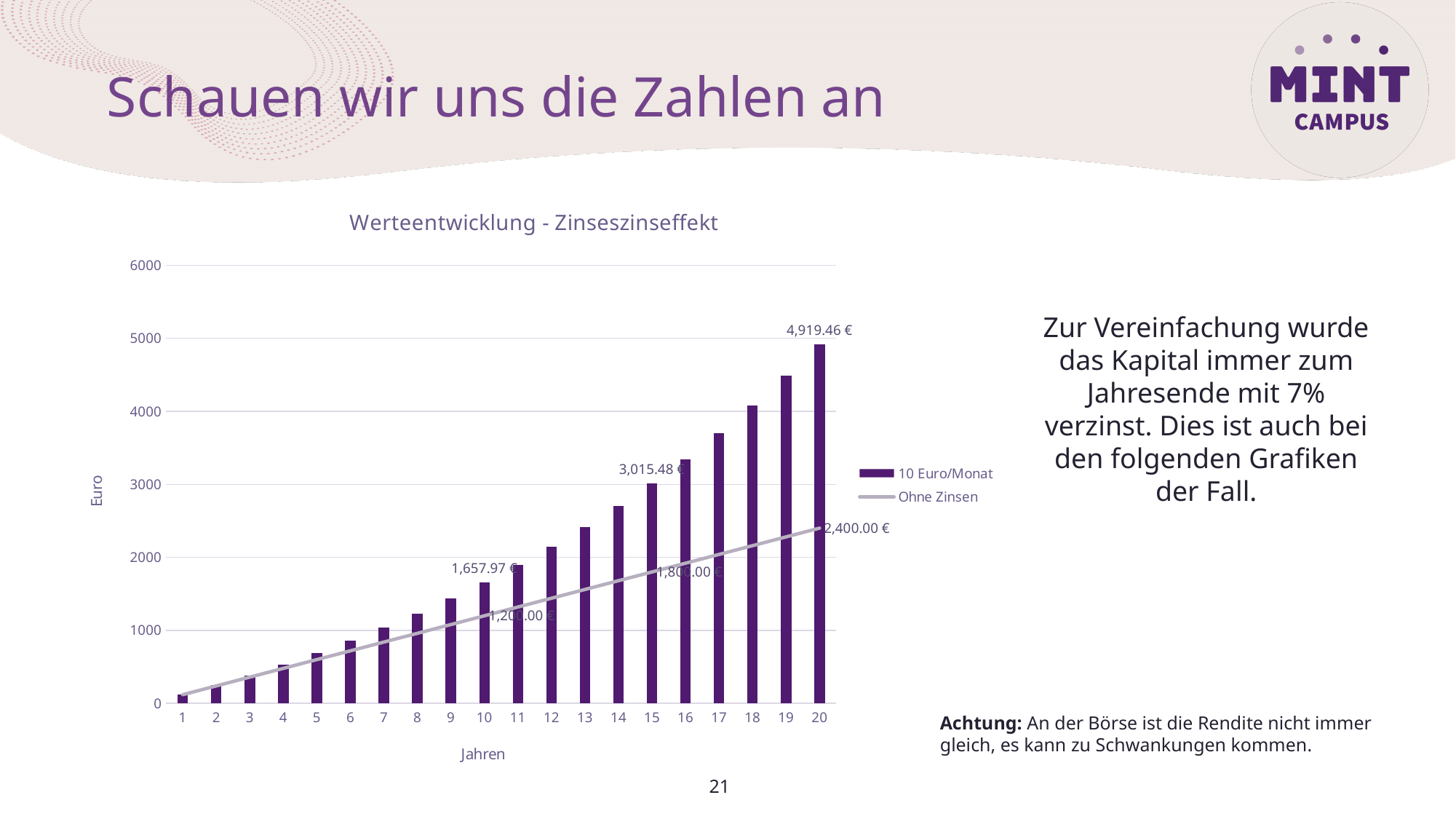
In which year is the 10 Euro/Monat bar the highest? 20 What is the difference between the 10 Euro/Monat value and the Ohne Zinsen value in year 20? 2,519.46 € How many series does the legend list? 2 Is the 10 Euro/Monat value in year 5 greater or less than 1000? less What is the value of the 10 Euro/Monat series in year 15? 3,015.48 € What is the title of the chart? Werteentwicklung - Zinseszinseffekt How many years are shown on the x axis? 20 What is the value of the Ohne Zinsen series in year 10? 1,200.00 € What is the value of the Ohne Zinsen series in year 20? 2,400.00 € Do the 10 Euro/Monat values rise or fall from year 1 to year 20? rise What is the value of the 10 Euro/Monat series in year 20? 4,919.46 € In year 10, which is larger: the 10 Euro/Monat value or the Ohne Zinsen value? 10 Euro/Monat